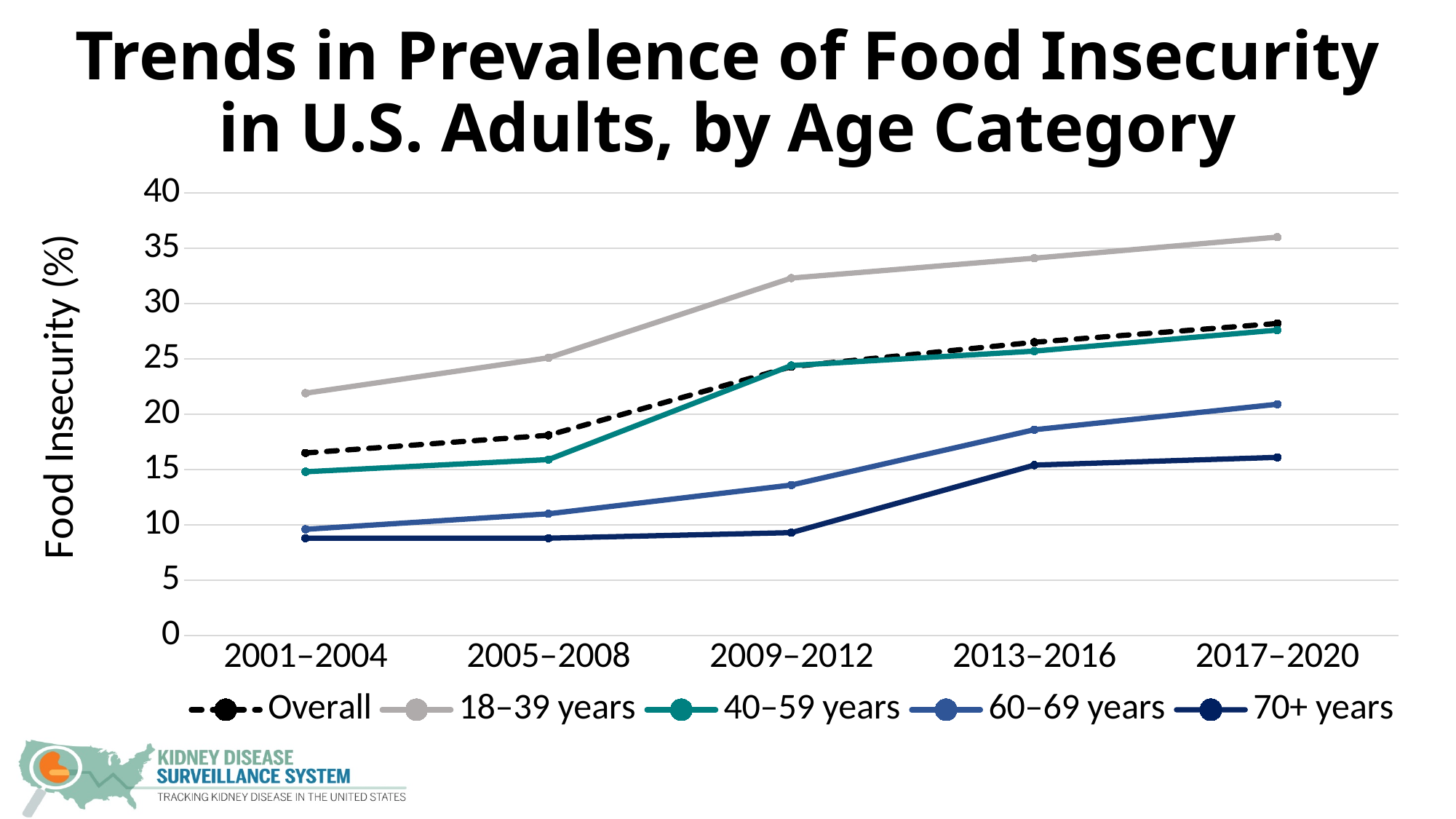
How many time periods are shown on the x axis? 5 In 2013–2016, which is larger: the value for 60–69 years or for 70+ years? 60–69 years Is the value for 70+ years in 2001–2004 greater or less than 10? less How many series does the legend list? 5 What kind of chart is shown on the slide? line chart Does food insecurity for the 18–39 years group rise or fall from 2001–2004 to 2017–2020? rise Which series is drawn with a dashed line? Overall Is the value for 18–39 years in 2017–2020 greater or less than 35? greater Which age category has the lowest food insecurity in 2017–2020? 70+ years Which age category has the highest food insecurity in 2017–2020? 18–39 years Is the value for 60–69 years in 2009–2012 greater or less than 15? less